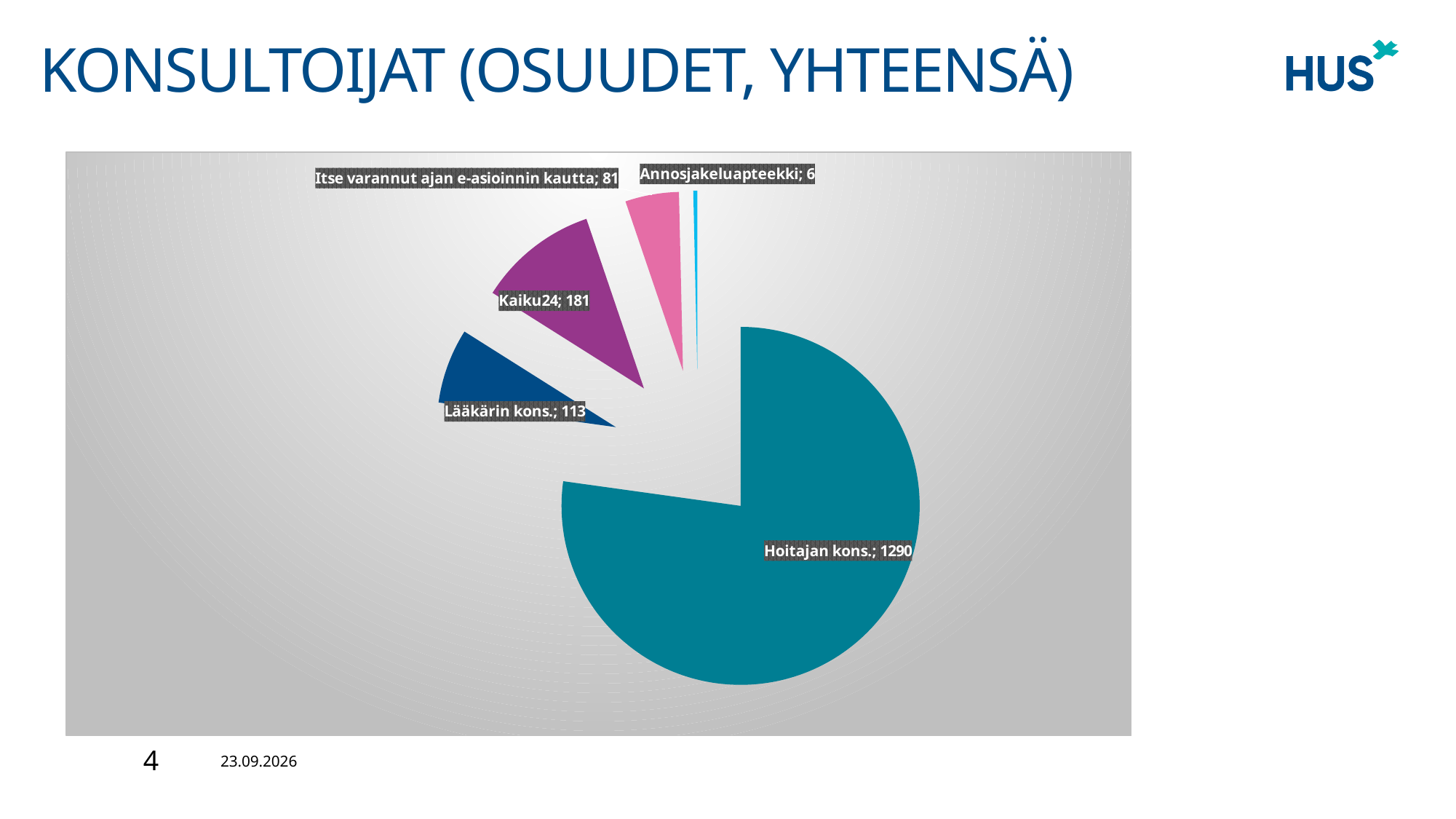
What is the title of the slide containing the pie chart? KONSULTOIJAT (OSUUDET, YHTEENSÄ) Which is larger, Lääkärin kons. or Itse varannut ajan e-asioinnin kautta? Lääkärin kons. What is the value for Kaiku24? 181 Which category has the smallest slice? Annosjakeluapteekki What is the value for Annosjakeluapteekki? 6 What is the difference between the values for Kaiku24 and Lääkärin kons.? 68 What kind of chart is shown on the slide? Pie chart What is the value for Itse varannut ajan e-asioinnin kautta? 81 How many slices does the pie chart have? 5 What is the value for Hoitajan kons.? 1290 What is the value for Lääkärin kons.? 113 Which category has the largest slice? Hoitajan kons.